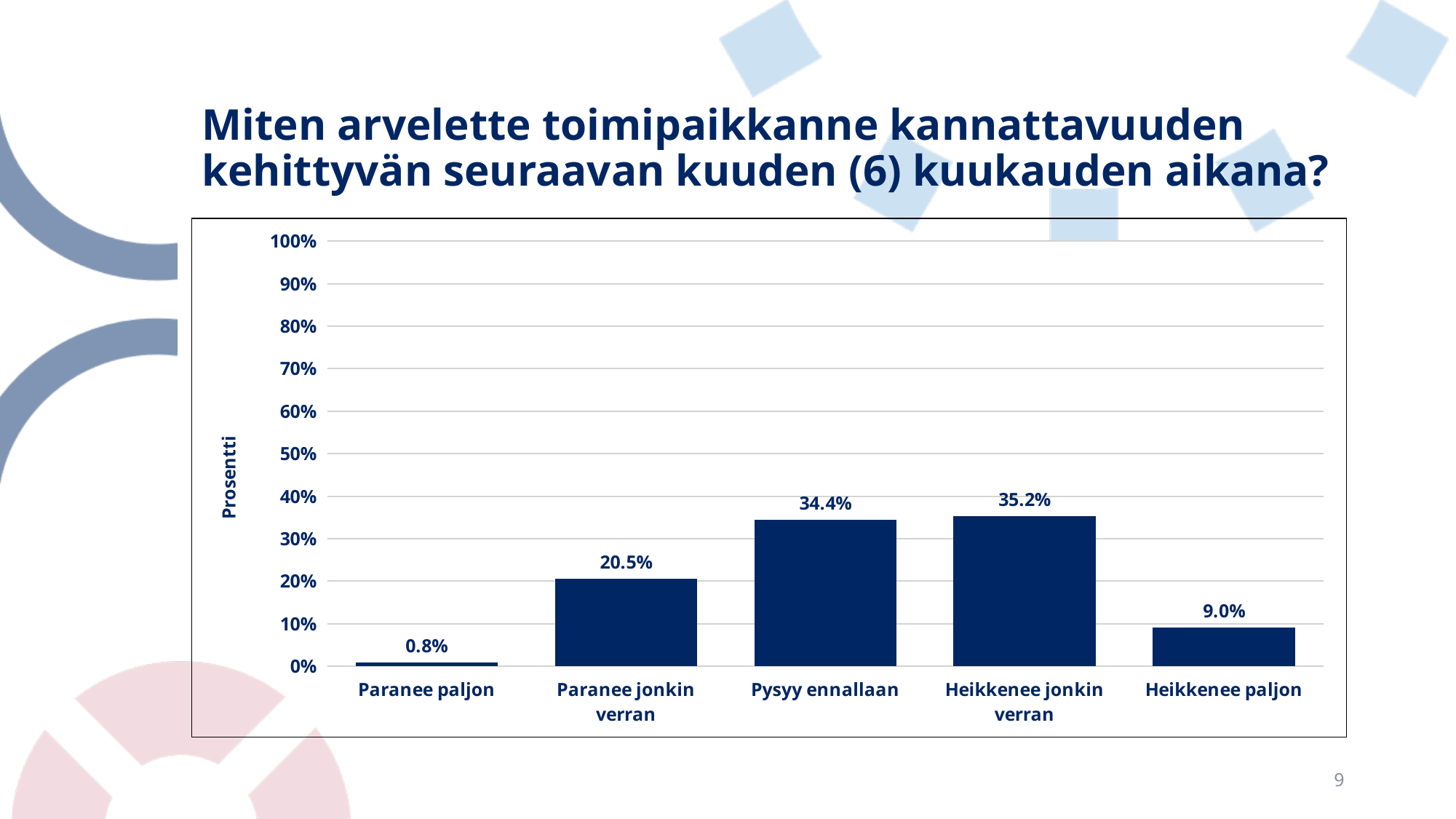
What is the difference between the values for "Heikkenee jonkin verran" and "Pysyy ennallaan"? 0.8% What is the value for "Paranee jonkin verran"? 20.5% What is the label of the vertical axis of the chart? Prosentti What is the value for "Pysyy ennallaan"? 34.4% Which category has the highest value? Heikkenee jonkin verran Which is larger, the value for "Paranee jonkin verran" or the value for "Heikkenee paljon"? Paranee jonkin verran How many categories are shown on the x axis of the chart? 5 Which category has the lowest value? Paranee paljon Is the value for "Pysyy ennallaan" greater or less than 30%? greater What is the value for "Heikkenee paljon"? 9.0% What is the value for "Paranee paljon"? 0.8% What kind of chart is shown on the slide? Bar chart